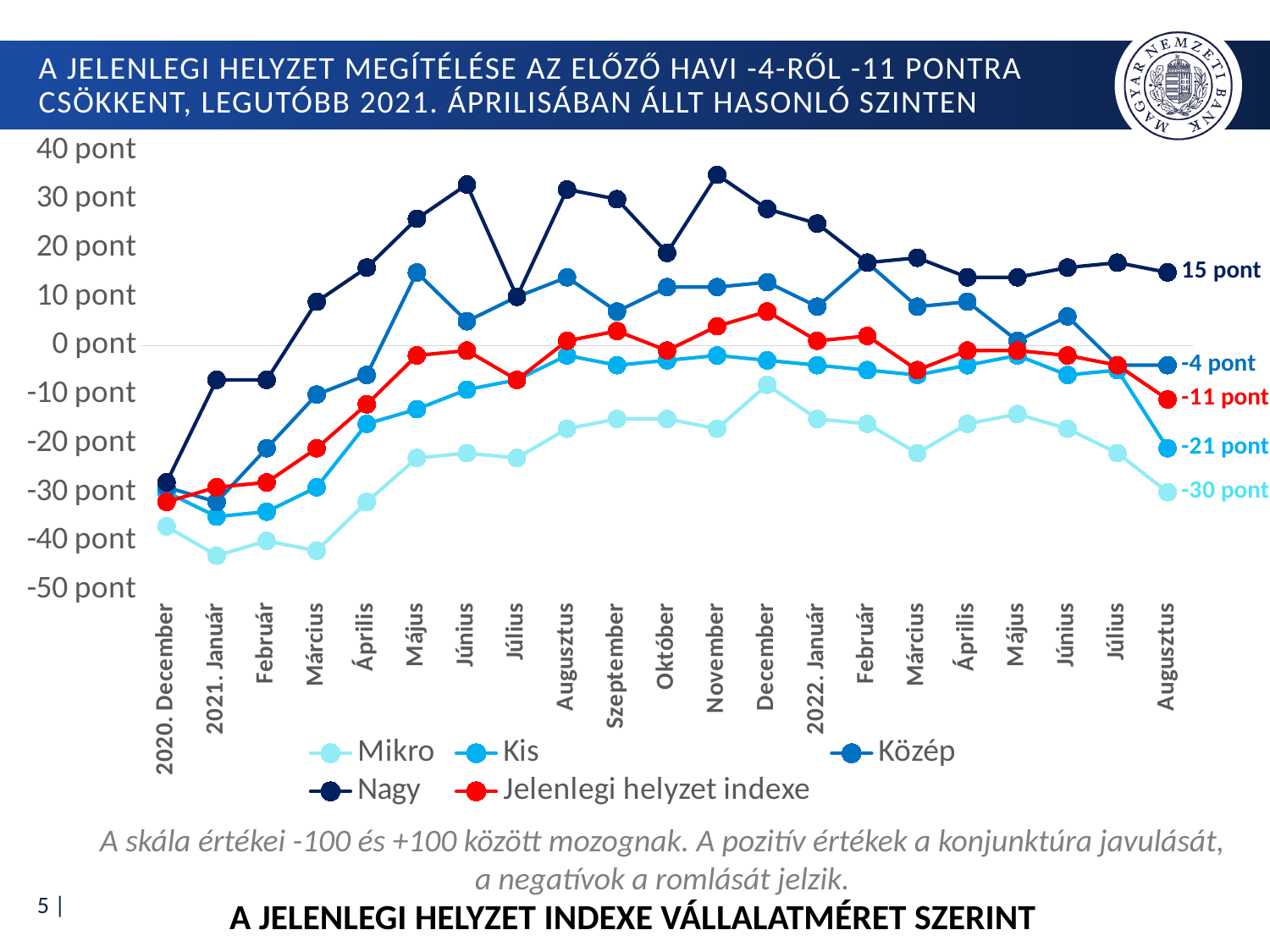
What is the difference between the Nagy and Mikro values in Augusztus 2022? 45 pont What is the value of the Jelenlegi helyzet indexe series in Augusztus 2022? -11 pont What is the value of the Nagy series in Augusztus 2022? 15 pont Which series has the highest value in Augusztus 2022? Nagy How many series does the legend list? 5 What is the value of the Közép series in Augusztus 2022? -4 pont How many months (points) are shown on the x axis? 21 What kind of chart is shown on the slide? Line chart What is the value of the Kis series in Augusztus 2022? -21 pont What is the value of the Mikro series in Augusztus 2022? -30 pont Which series has the lowest value in Augusztus 2022? Mikro Is the value of the Nagy series in 2021 Június greater or less than 30 pont? greater